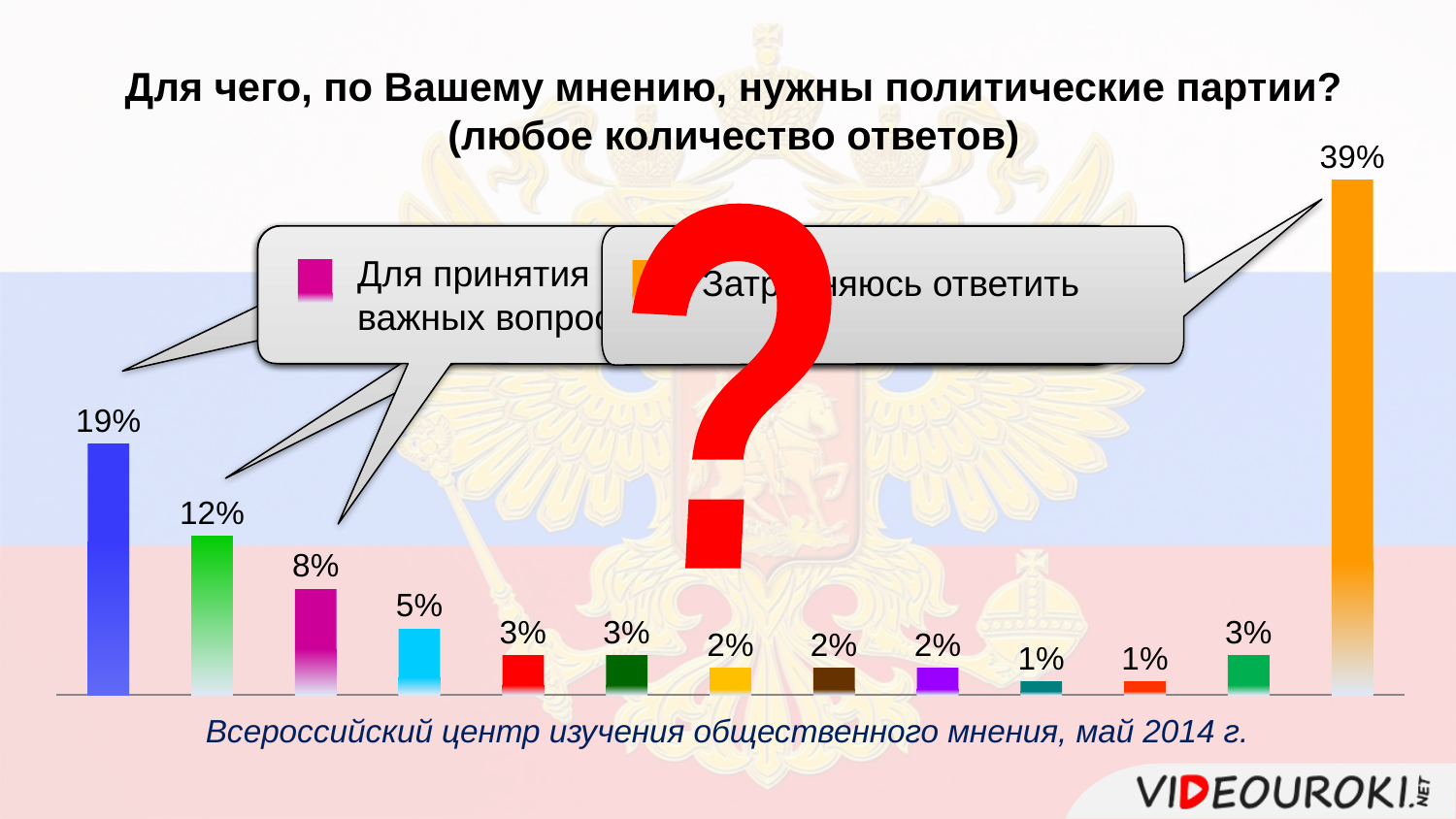
Which is larger: the value of the blue bar on the far left or the value of the green bar next to it? the blue bar (19%) What is the difference between the orange bar (39%) and the blue bar (19%)? 20% What kind of chart is shown on the slide? bar chart What is the value of the tallest bar in the chart? 39% What is the value of the orange bar labelled "Затрудняюсь ответить"? 39% What is the difference between the magenta bar (8%) and the light-blue bar (5%)? 3% What is the value of the magenta bar ("Для принятия важных вопросов")? 8% According to the caption under the chart, which organisation and date is the data from? Всероссийский центр изучения общественного мнения, май 2014 г. What is the lowest value shown on any bar in the chart? 1% How many bars are plotted in the chart? 13 What is the value of the first (blue) bar on the left of the chart? 19% What is the value of the second (green) bar from the left? 12%